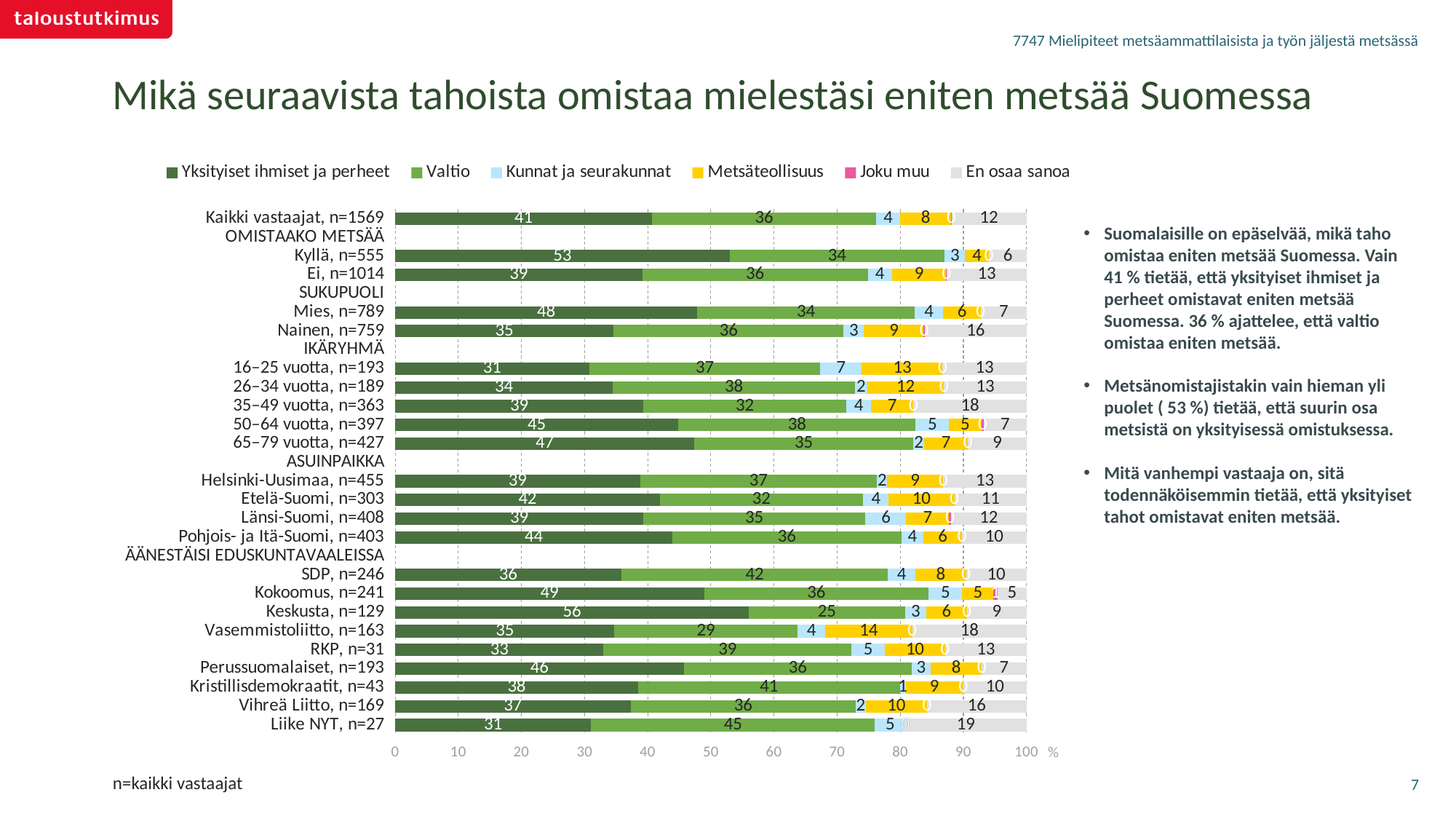
Which series is shown in yellow in the legend? Metsäteollisuus What is the title of the chart? Mikä seuraavista tahoista omistaa mielestäsi eniten metsää Suomessa What kind of chart is shown on the slide? stacked bar chart Which category has the highest value for Yksityiset ihmiset ja perheet? Keskusta, n=129 What is the value for Yksityiset ihmiset ja perheet for Kaikki vastaajat, n=1569? 41 How many series does the legend list? 6 What is the value for En osaa sanoa for Vasemmistoliitto, n=163? 18 What is the value for Valtio for Nainen, n=759? 36 What is the value for Metsäteollisuus for 16–25 vuotta, n=193? 13 What is the difference between the Yksityiset ihmiset ja perheet values for Kyllä, n=555 and Ei, n=1014? 14 Which category has the highest value for En osaa sanoa? Liike NYT, n=27 Which is larger: the Valtio value for SDP, n=246 or for Kokoomus, n=241? SDP, n=246